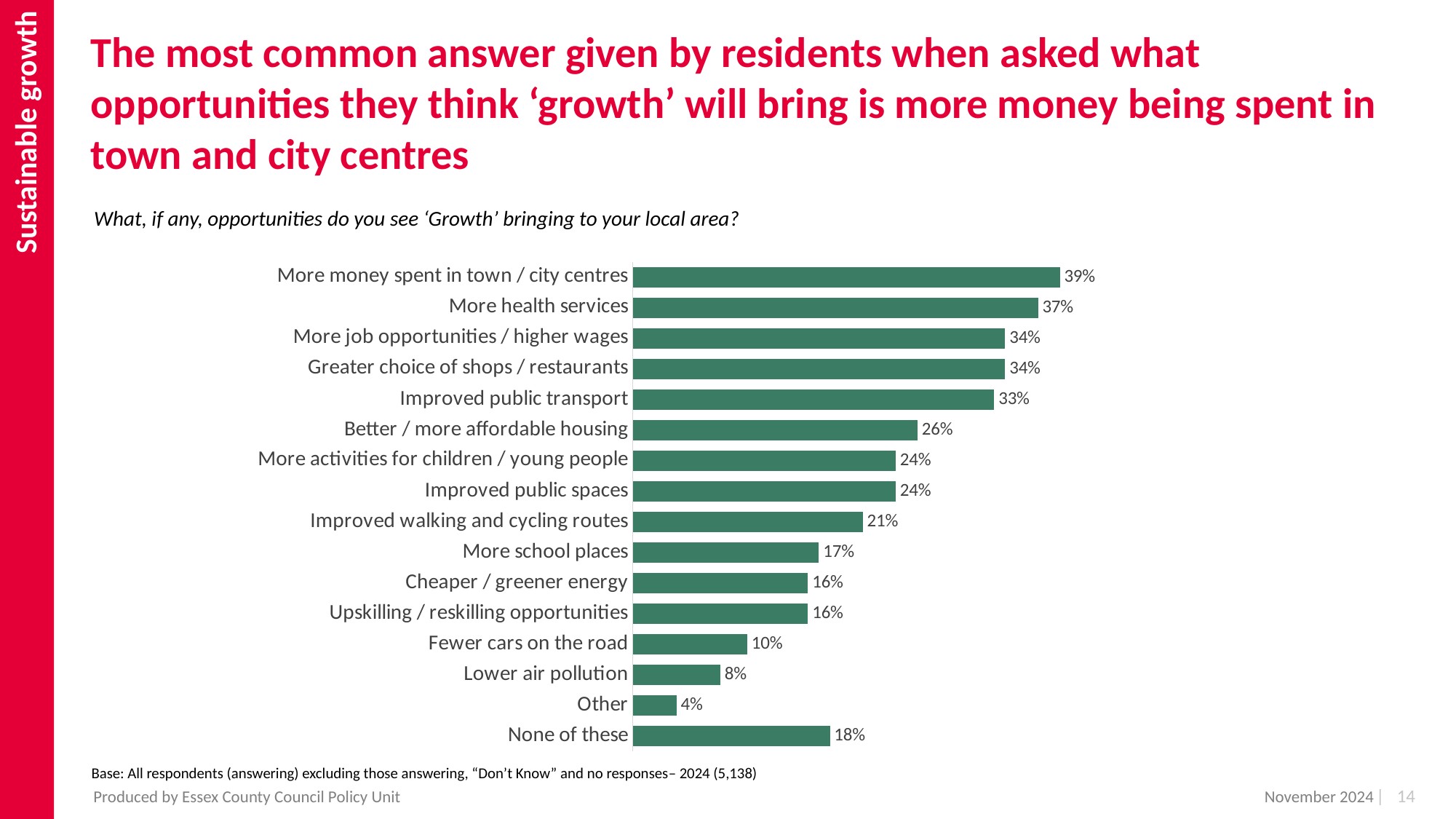
What is the difference between 'More health services' and 'Better / more affordable housing'? 11 percentage points How many categories are shown in the chart? 16 Which category has the highest value? More money spent in town / city centres What is the value for 'Improved walking and cycling routes'? 21% Which category has the lowest value? Other Which is larger: 'More school places' or 'Fewer cars on the road'? More school places What kind of chart is shown on the slide? Bar chart What survey question is the chart based on? What, if any, opportunities do you see 'Growth' bringing to your local area? What percentage of respondents chose 'None of these'? 18% What is the value for 'Improved public transport'? 33% What is the difference between 'Lower air pollution' and 'Other'? 4 percentage points What percentage of respondents said 'More money spent in town / city centres'? 39%